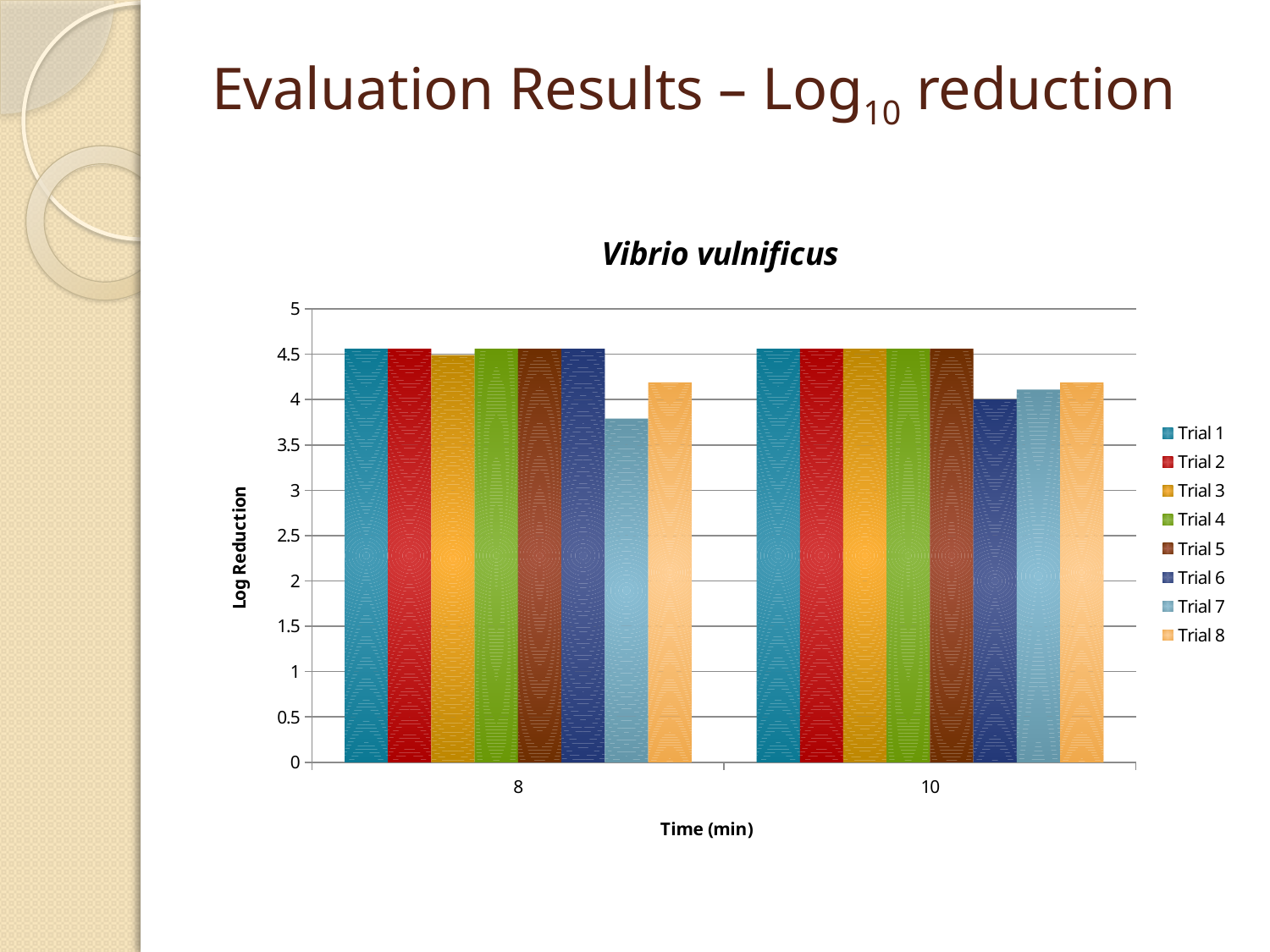
Is the value for Trial 8 at 8 min greater or less than 4? greater At 8 min, which is larger: the value for Trial 7 or the value for Trial 8? Trial 8 What kind of chart is shown on the slide? bar chart How many time categories are shown on the x axis? 2 How many series does the legend list? 8 Which trial has the lowest log reduction at 8 min? Trial 7 Which is larger for Trial 7: the value at 8 min or the value at 10 min? 10 min What is the title of the chart? Vibrio vulnificus Is the value for Trial 7 at 8 min greater or less than 4? less Is the value for Trial 7 at 8 min greater or less than 3.5? greater What is the label of the vertical axis? Log Reduction Which trial has the lowest log reduction at 10 min? Trial 6